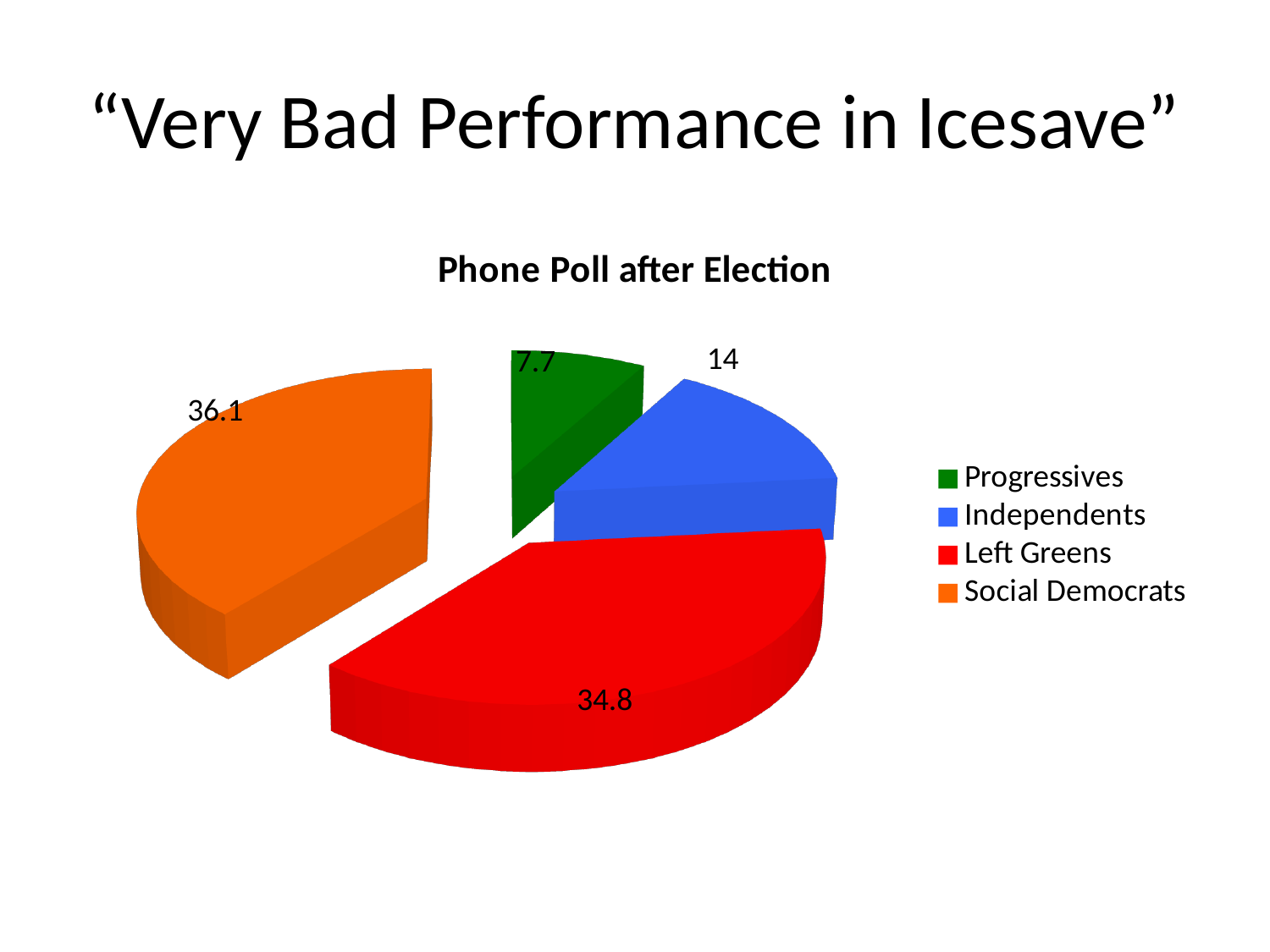
What value is shown for Left Greens in the pie chart? 34.8 What value is shown for Social Democrats in the pie chart? 36.1 What is the difference between the values for Social Democrats and Left Greens? 1.3 What kind of chart is shown on the slide? Pie chart What value is shown for Independents in the pie chart? 14 How many slices does the pie chart have? 4 Which party has the largest slice in the pie chart? Social Democrats What value is shown for Progressives in the pie chart? 7.7 What is the difference between the values for Independents and Progressives? 6.3 Which is larger, the value for Independents or the value for Progressives? Independents Which party has the smallest slice in the pie chart? Progressives What is the title of the chart? Phone Poll after Election